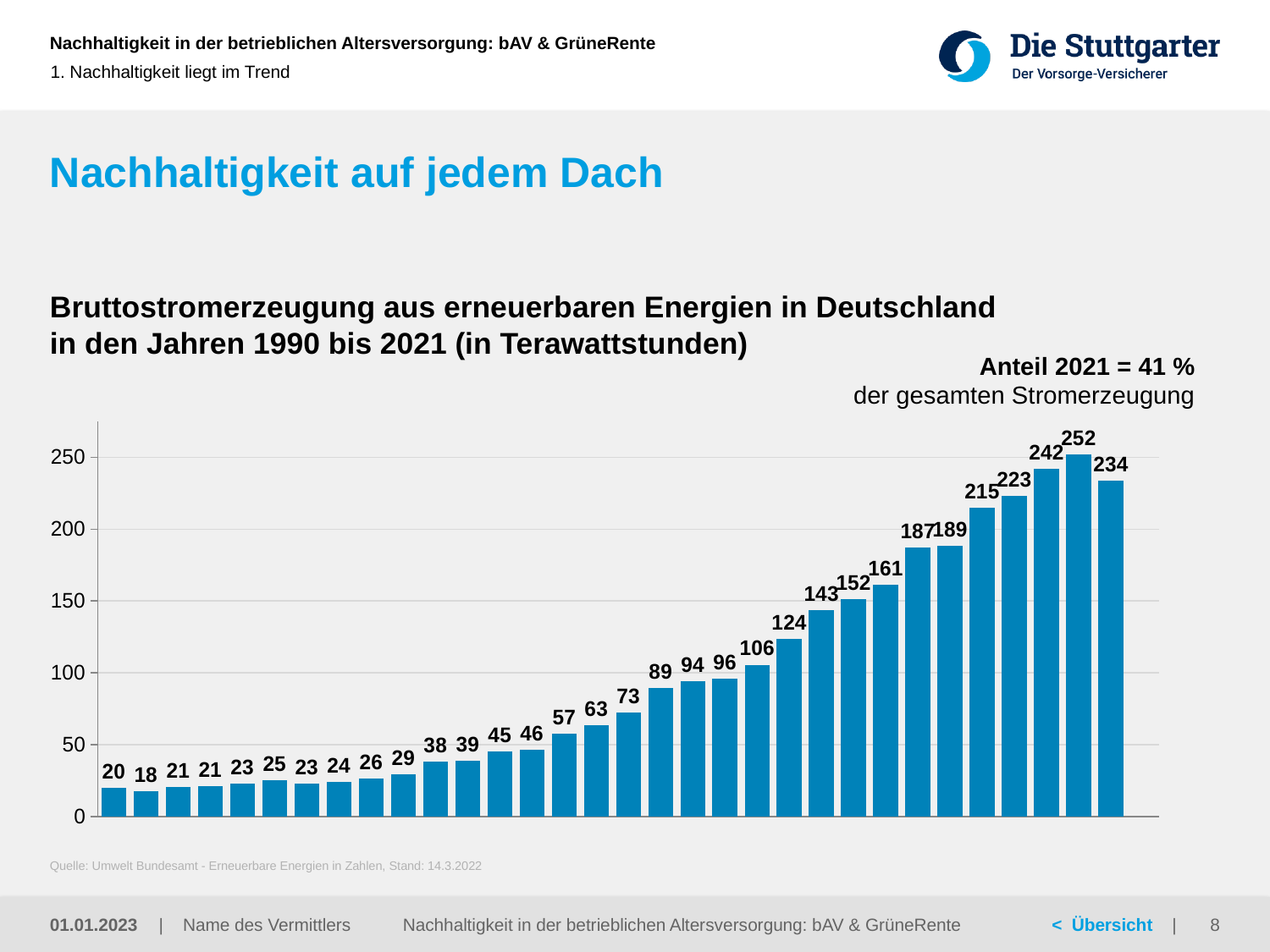
Which is larger: the value of the first bar (20) or the value of the second bar (18)? the first bar (20) By how much is the last bar (234) lower than the highest bar (252)? 18 What is the difference between the highest value (252) and the lowest value (18) in the chart? 234 What is the value of the last bar (2021) in the chart? 234 What is the lowest value shown in the chart? 18 Do the values generally rise or fall from left to right along the x axis? rise How many bars are plotted in the chart? 32 According to the slide, what share of total electricity generation did renewables have in 2021? 41 % What is the value of the first bar (1990) in the chart? 20 What type of chart is shown on the slide? bar chart In which unit are the values in the chart given, according to the chart title? Terawattstunden What is the highest value shown in the chart? 252